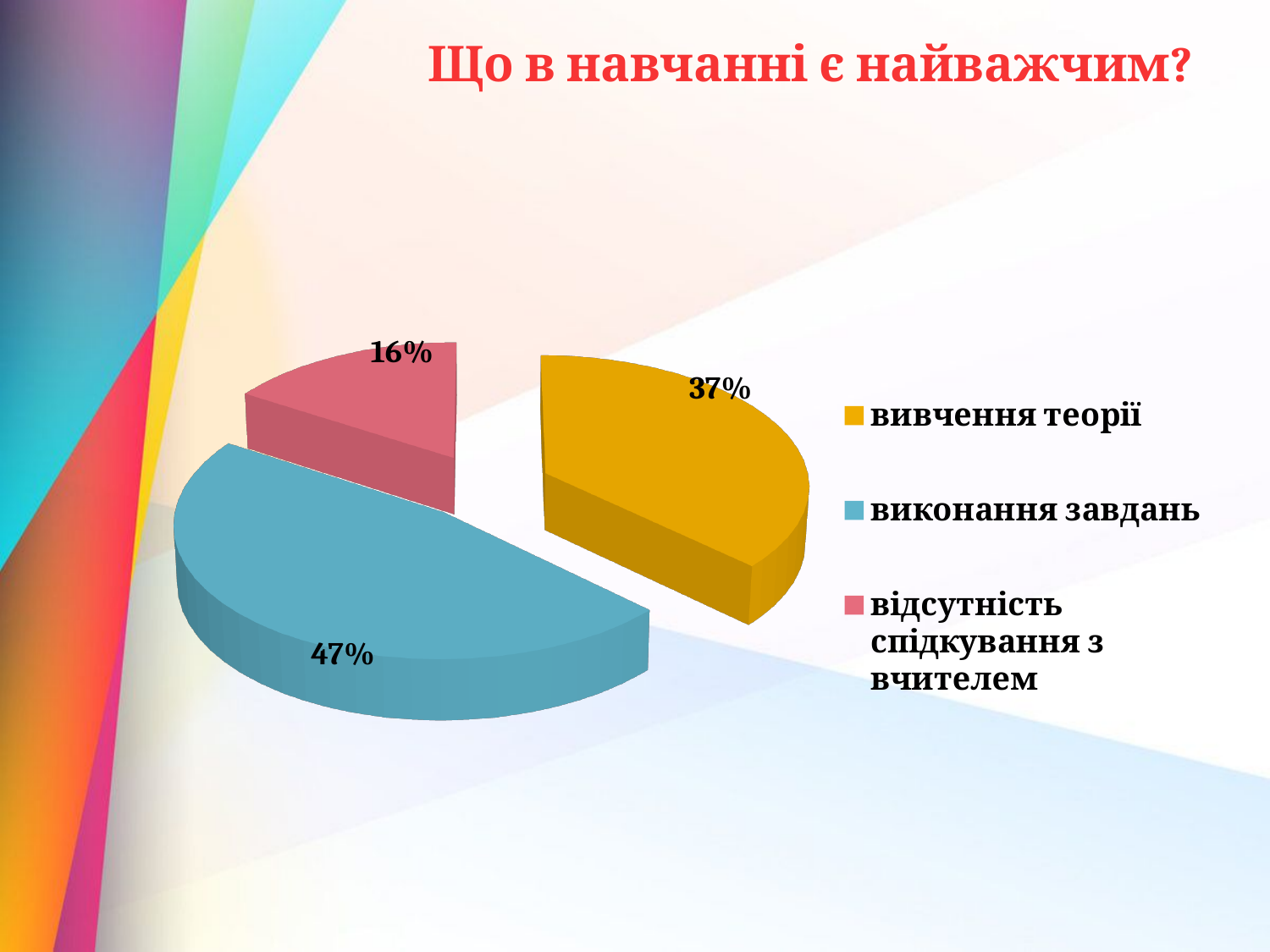
What is the difference in percentage points between "виконання завдань" and "вивчення теорії"? 10 What percentage is shown for "виконання завдань"? 47% What is the title of the slide above the chart? Що в навчанні є найважчим? What percentage is shown for "відсутність спідкування з вчителем"? 16% Which is larger: the share for "вивчення теорії" or the share for "відсутність спідкування з вчителем"? вивчення теорії What kind of chart is shown on the slide? pie chart How many slices does the pie chart have? 3 What percentage is shown for "вивчення теорії"? 37% What is the difference in percentage points between "вивчення теорії" and "відсутність спідкування з вчителем"? 21 Which category has the largest share of the pie? виконання завдань Which category has the smallest share of the pie? відсутність спідкування з вчителем What colour is the slice for "виконання завдань"? blue